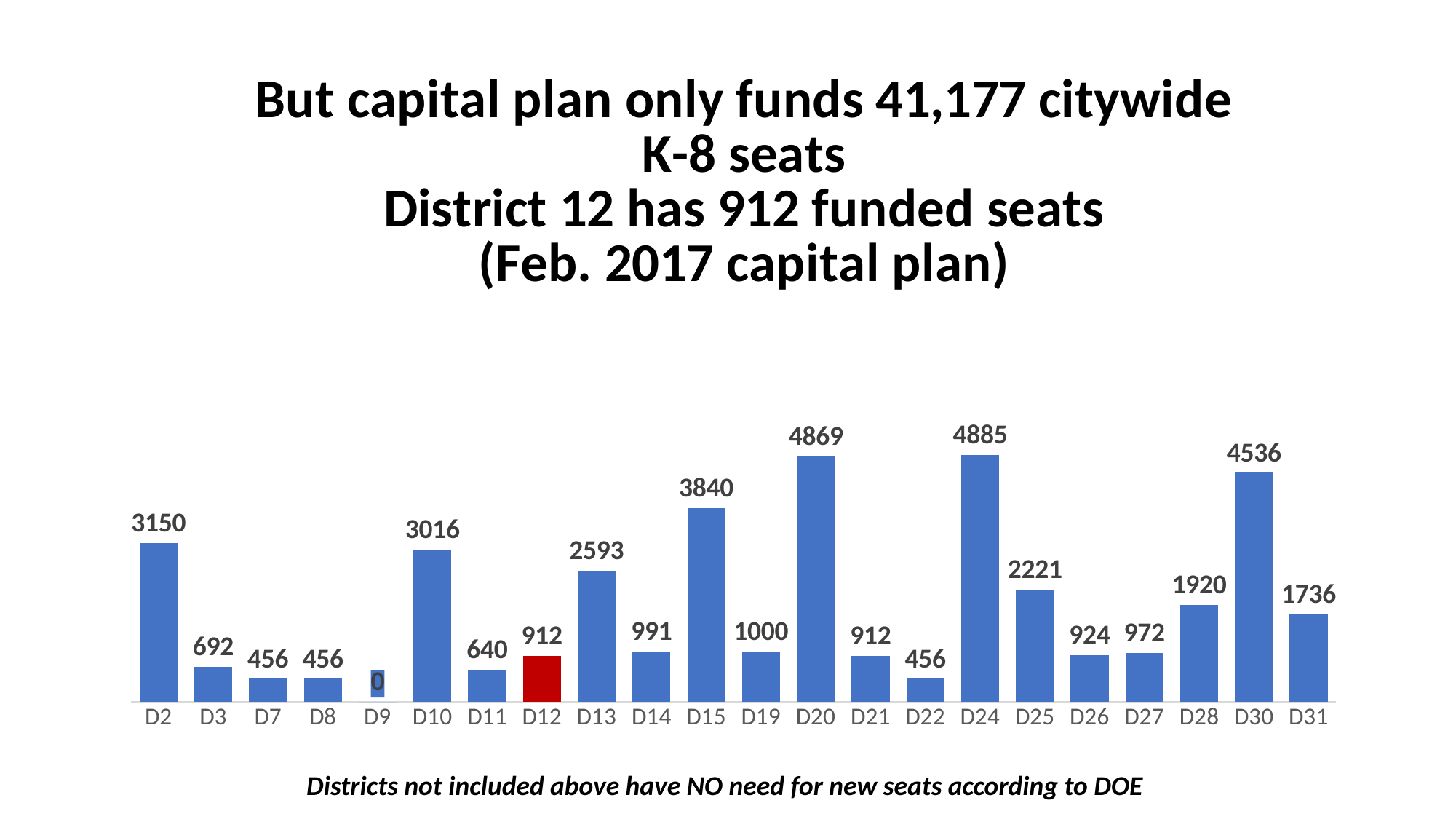
What value is shown for D9? 0 What is the difference between the values for D30 and D31? 2800 What value is shown for D20? 4869 Which district has the lowest value? D9 What is the difference between the values for D2 and D12? 2238 What value is shown for D25? 2221 What kind of chart is this? Bar chart What value is shown for D12? 912 Which district's bar is coloured red? D12 Which district has the highest value? D24 How many districts are shown on the x axis? 22 Which has a larger value, D15 or D13? D15